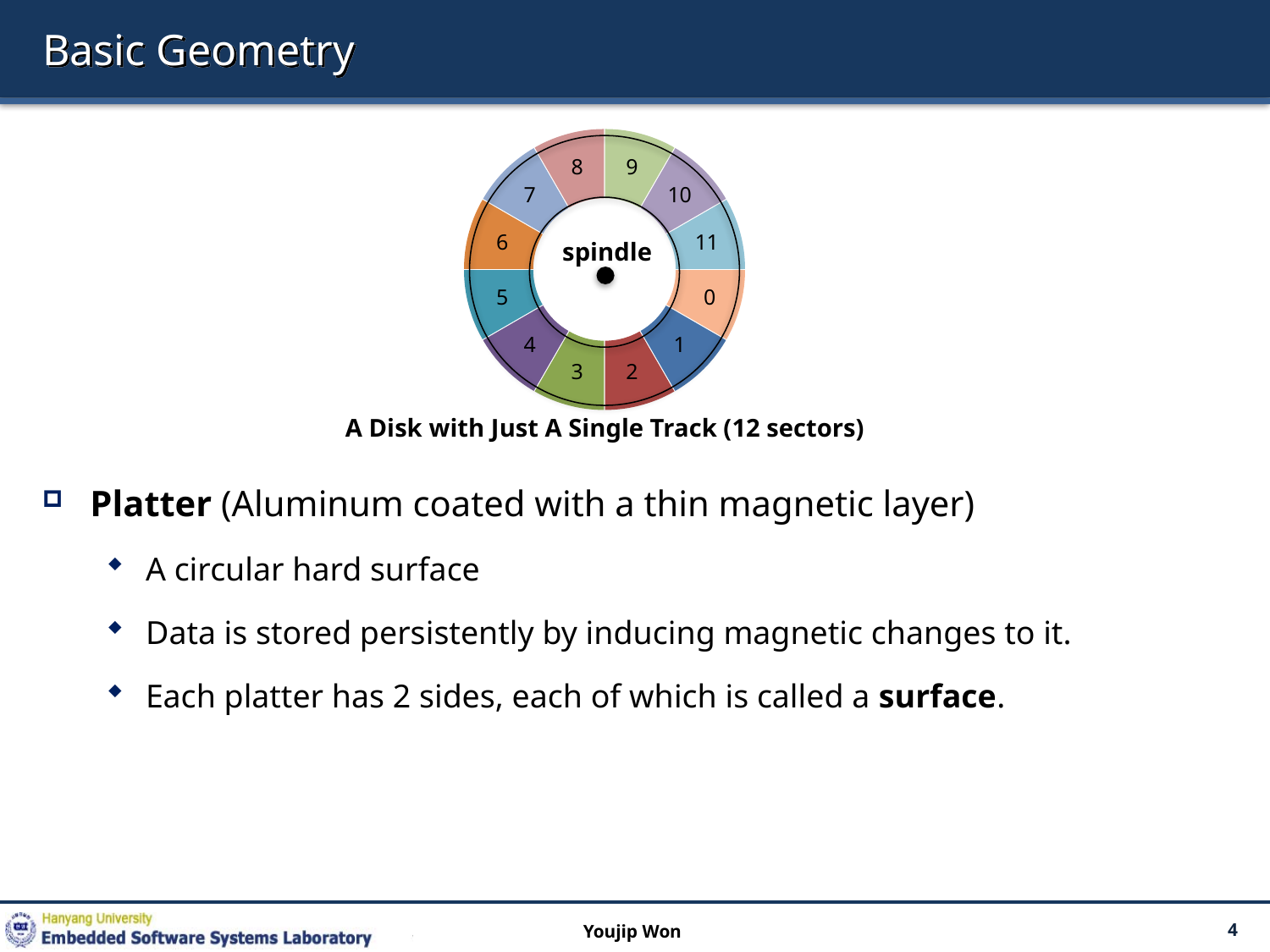
What is the caption below the disk diagram? A Disk with Just A Single Track (12 sectors) What is the lowest sector number labeled on the disk diagram? 0 What kind of chart is used to draw the disk with a single track? doughnut chart What label is printed at the center of the disk diagram? spindle How many sectors are shown in the disk diagram? 12 What is the highest sector number labeled on the disk diagram? 11